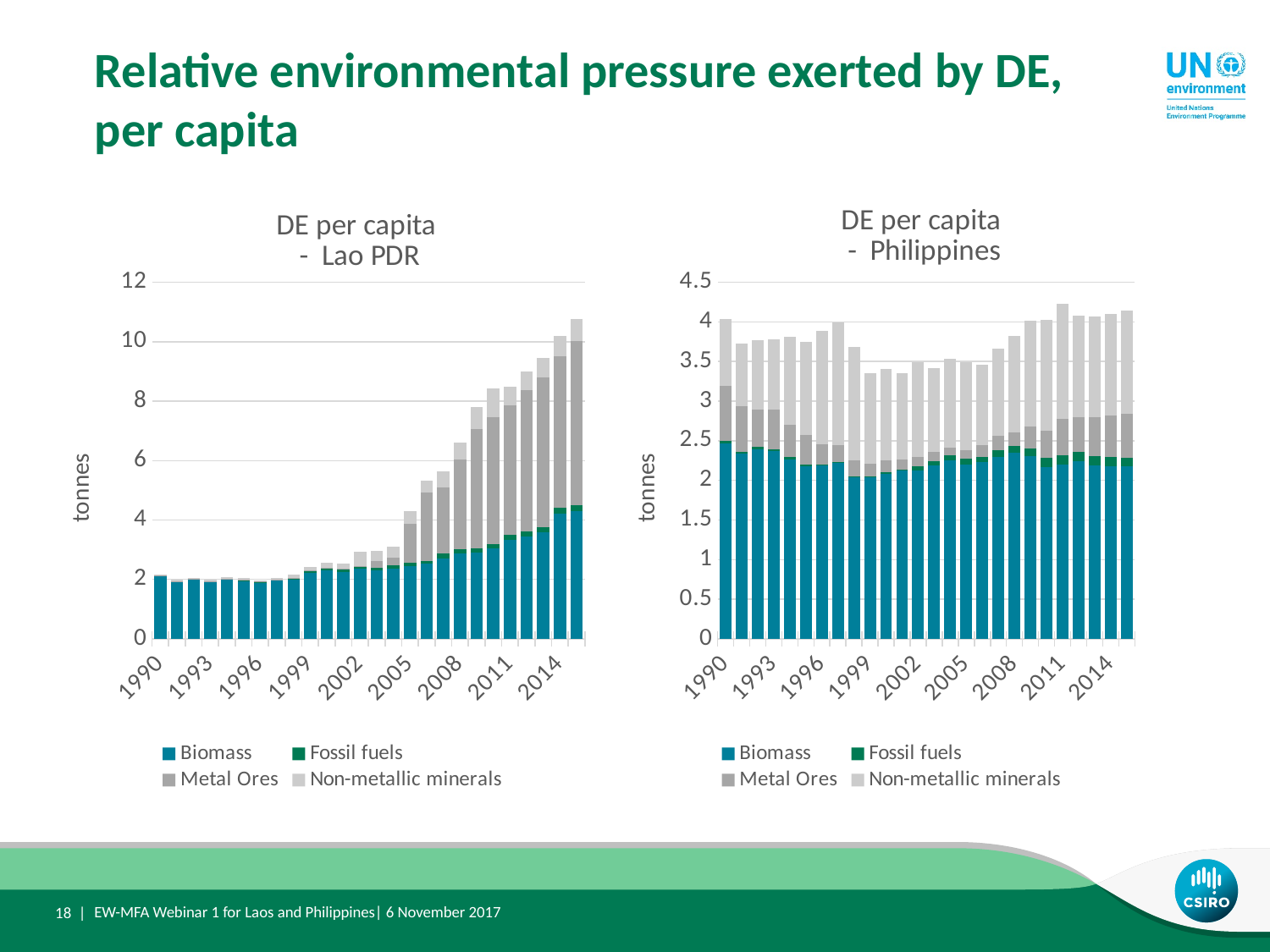
In the 'DE per capita - Philippines' chart, is the total for 1990 greater or less than 4.5? less What is the y-axis label on the 'DE per capita - Philippines' chart? tonnes In the 'DE per capita - Lao PDR' chart, which is larger, the total for 2014 or the total for 1990? 2014 In the 'DE per capita - Philippines' chart, is the total for 2000 greater or less than 3.5? less What kind of chart is the 'DE per capita - Lao PDR' chart? stacked bar chart In the 'DE per capita - Philippines' chart, is the Biomass value for 1990 greater or less than 2? greater How many series does the legend of the 'DE per capita - Philippines' chart list? 4 In the 'DE per capita - Lao PDR' chart, which year has the highest total bar? 2015 In the 'DE per capita - Lao PDR' chart, do the total values generally rise or fall from 2000 to 2015? rise